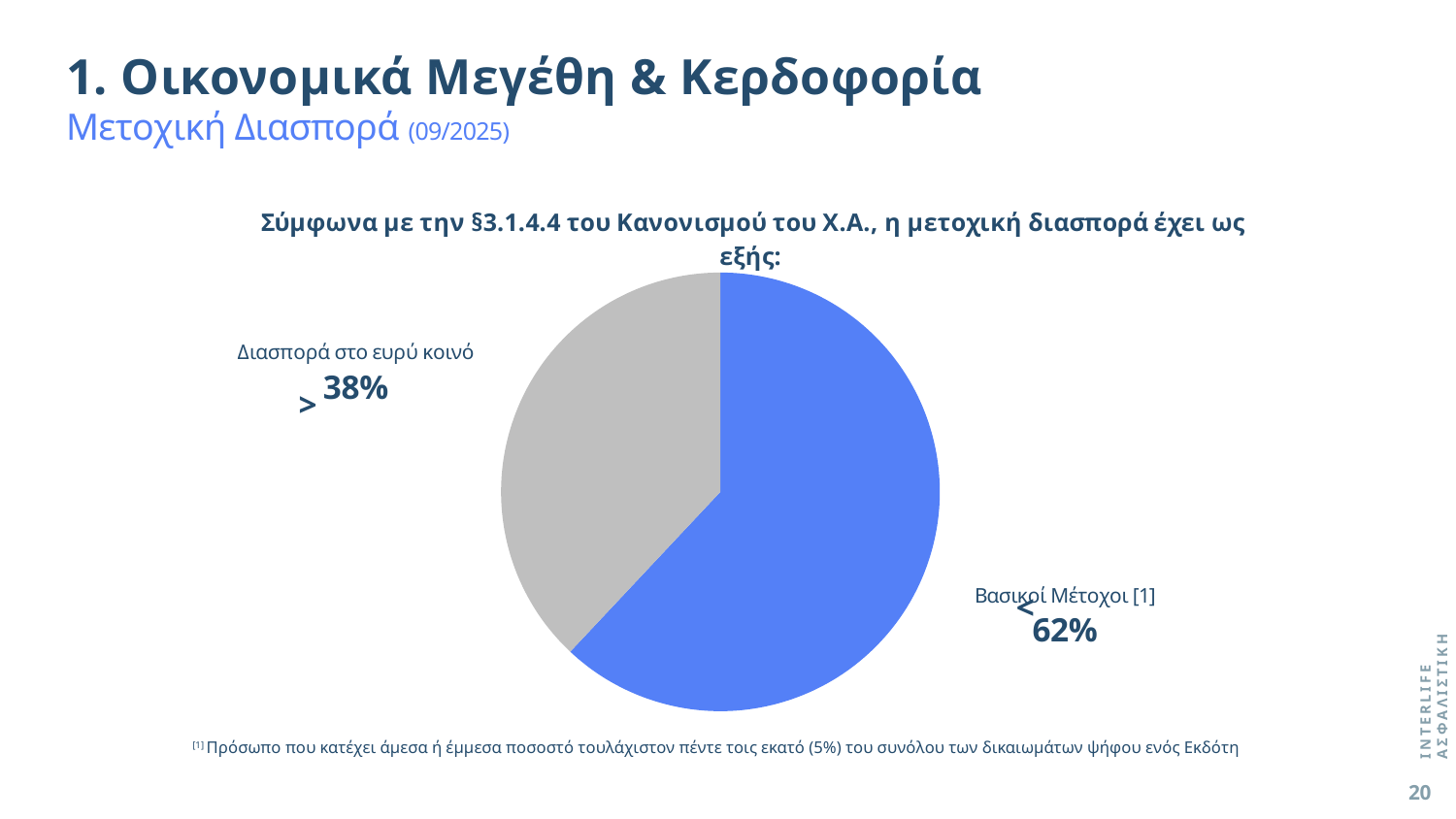
What share of the pie is labelled 'Βασικοί Μέτοχοι [1]'? 62% What is the difference in percentage points between 'Βασικοί Μέτοχοι [1]' and 'Διασπορά στο ευρύ κοινό'? 24 percentage points What type of chart is shown on the slide? Pie chart What is the total of the two pie slices shown? 100% What colour is the slice for 'Βασικοί Μέτοχοι [1]'? Blue Which is larger: the share for 'Βασικοί Μέτοχοι [1]' or the share for 'Διασπορά στο ευρύ κοινό'? Βασικοί Μέτοχοι [1] Which slice of the pie chart is the smallest? Διασπορά στο ευρύ κοινό What colour is the slice for 'Διασπορά στο ευρύ κοινό'? Grey What share of the pie is labelled 'Διασπορά στο ευρύ κοινό'? 38% Which slice of the pie chart is the largest? Βασικοί Μέτοχοι [1] How many slices does the pie chart have? 2